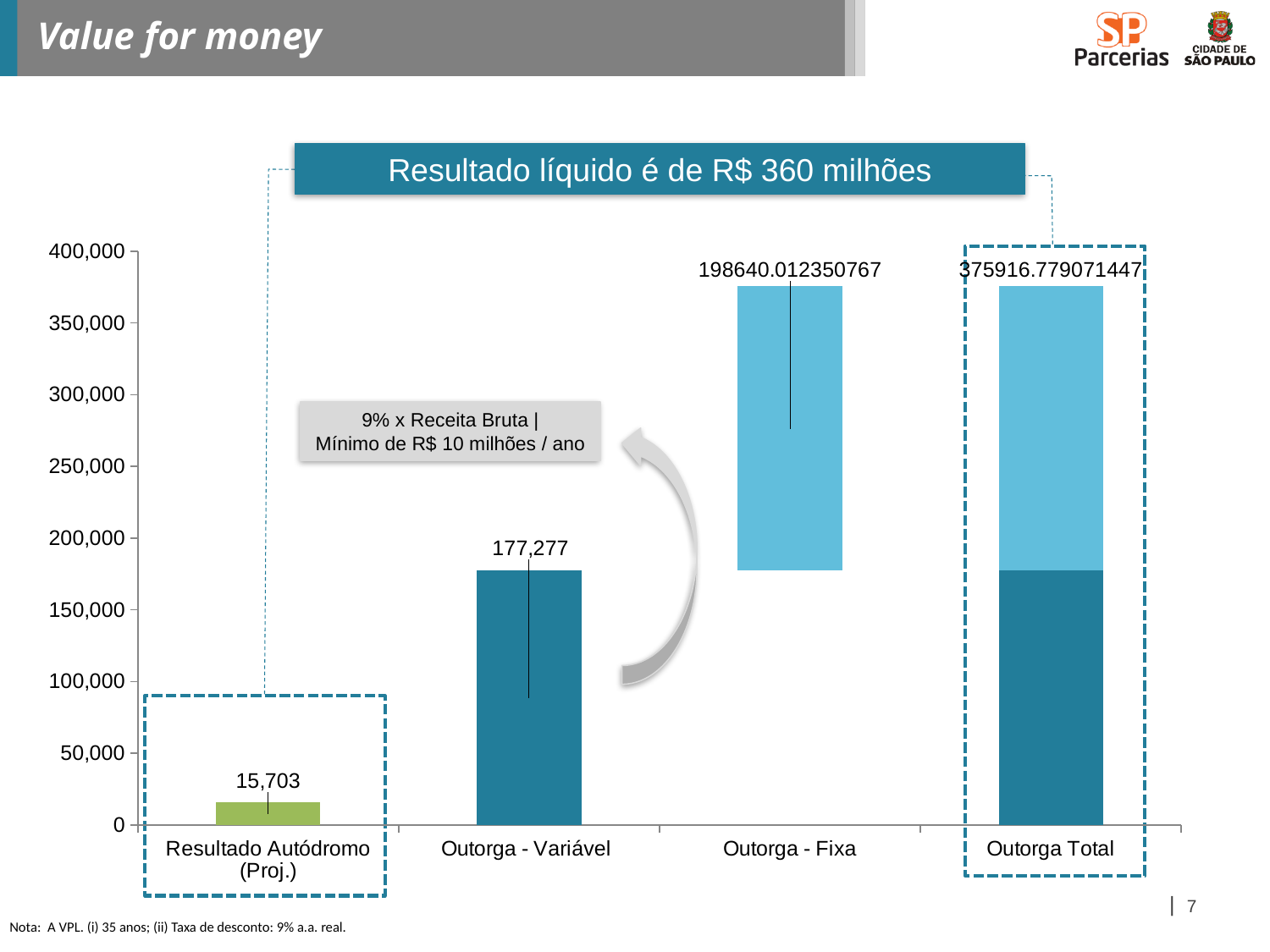
Which category has the highest value? Outorga Total What kind of chart is shown on the slide? bar chart Which category has the lowest value? Resultado Autódromo (Proj.) How many categories are shown on the x axis? 4 Which is larger, the value for Outorga - Variável or the value for Resultado Autódromo (Proj.)? Outorga - Variável What is the data label shown above the Outorga Total bar? 375916.779071447 What is the value shown for Resultado Autódromo (Proj.)? 15,703 What is the difference between the value for Outorga - Variável and the value for Resultado Autódromo (Proj.)? 161,574 What text appears in the blue box above the chart? Resultado líquido é de R$ 360 milhões Is the value for Outorga - Variável greater or less than 150,000? greater What is the data label shown above the Outorga - Fixa bar? 198640.012350767 What is the value shown for Outorga - Variável? 177,277